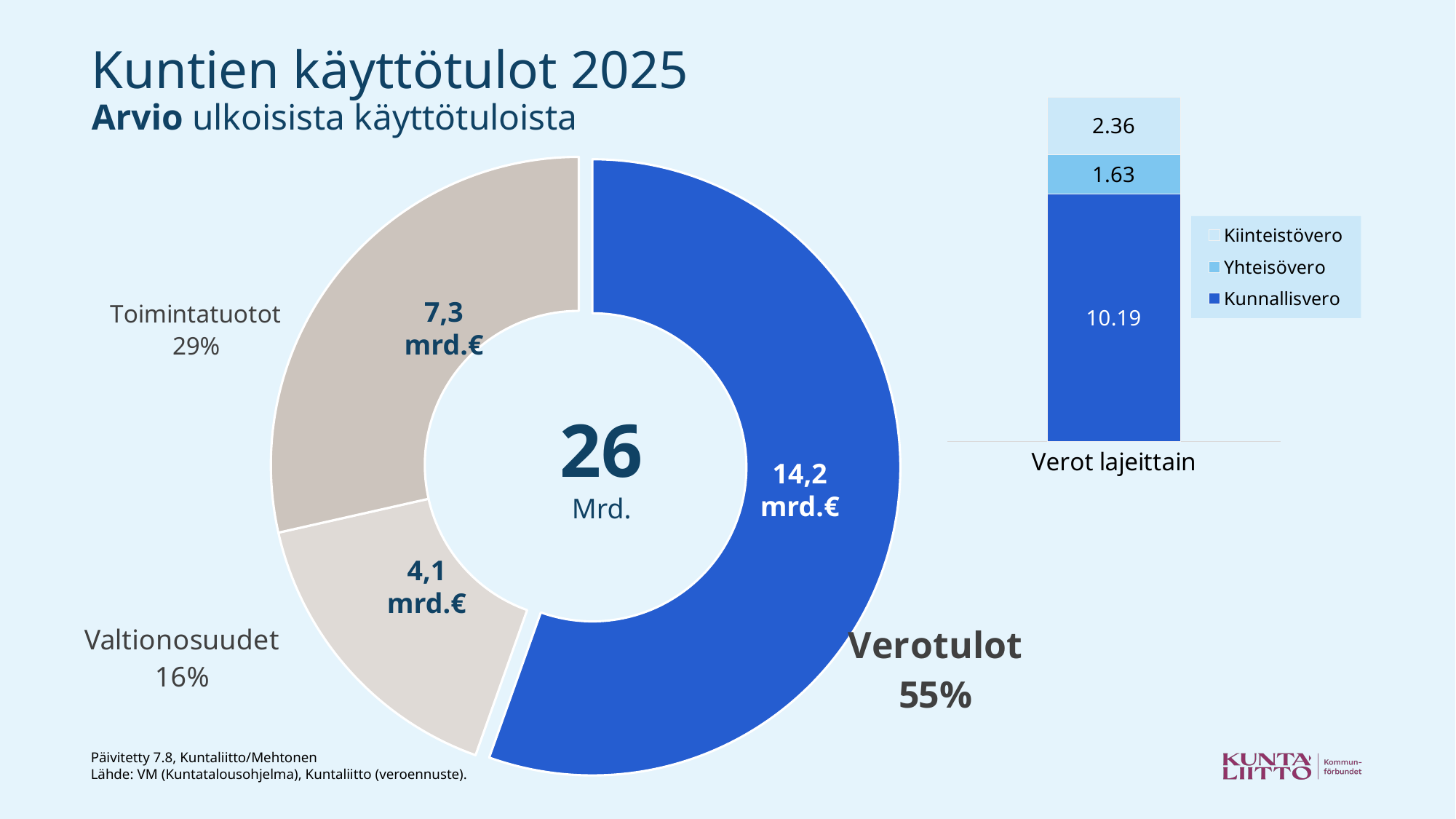
In the donut chart, which category is the smallest? Valtionosuudet In the donut chart, what is the difference between Toimintatuotot and Valtionosuudet in mrd.€? 3,2 mrd.€ In the donut chart, what is the value for Valtionosuudet? 4,1 mrd.€ In the Verot lajeittain chart, which of Kiinteistövero and Yhteisövero is larger? Kiinteistövero In the donut chart, what share of the total does Toimintatuotot represent? 29% In the donut chart, what is the value for Verotulot? 14,2 mrd.€ In the Verot lajeittain chart, what is the total of the stacked bar? 14.18 In the donut chart, which category is the largest? Verotulot In the donut chart, what total value is shown in the centre? 26 Mrd. In the Verot lajeittain chart, what is the value for Kunnallisvero? 10.19 In the donut chart, how many categories are shown? 3 In the Verot lajeittain chart, how many series does the legend list? 3